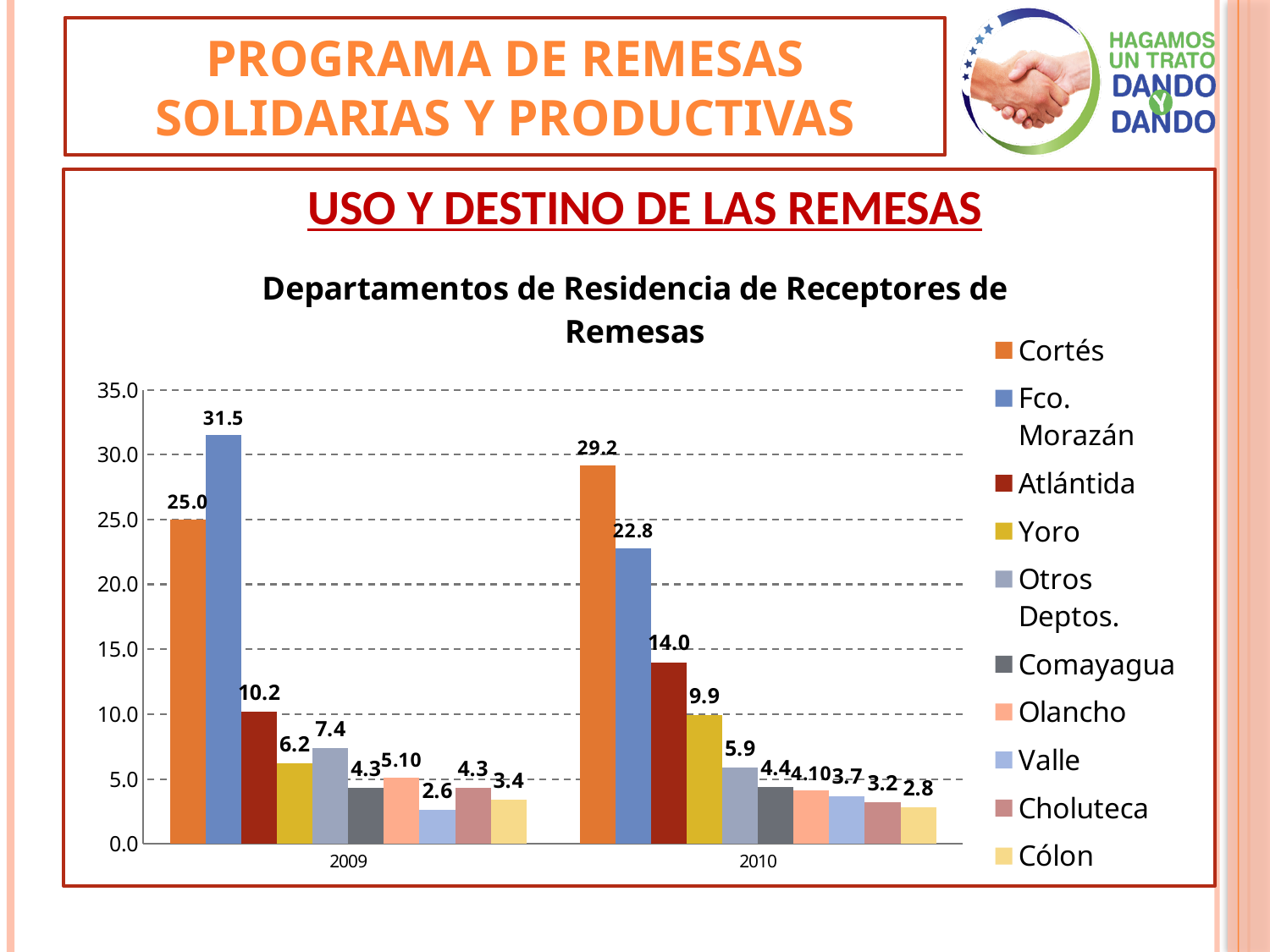
What is the value for Atlántida in 2010? 14.0 What is the value for Cortés in 2010? 29.2 Which department has the lowest value in 2010? Cólon What kind of chart is shown on the slide? Bar chart Which department has the highest value in 2009? Fco. Morazán Which is larger in 2010: Cortés or Fco. Morazán? Cortés What is the difference between the Cortés values for 2010 and 2009? 4.2 What is the value for Valle in 2009? 2.6 Does the value for Fco. Morazán rise or fall from 2009 to 2010? Fall What is the value for Fco. Morazán in 2009? 31.5 What is the title of the chart? Departamentos de Residencia de Receptores de Remesas How many series does the legend list? 10